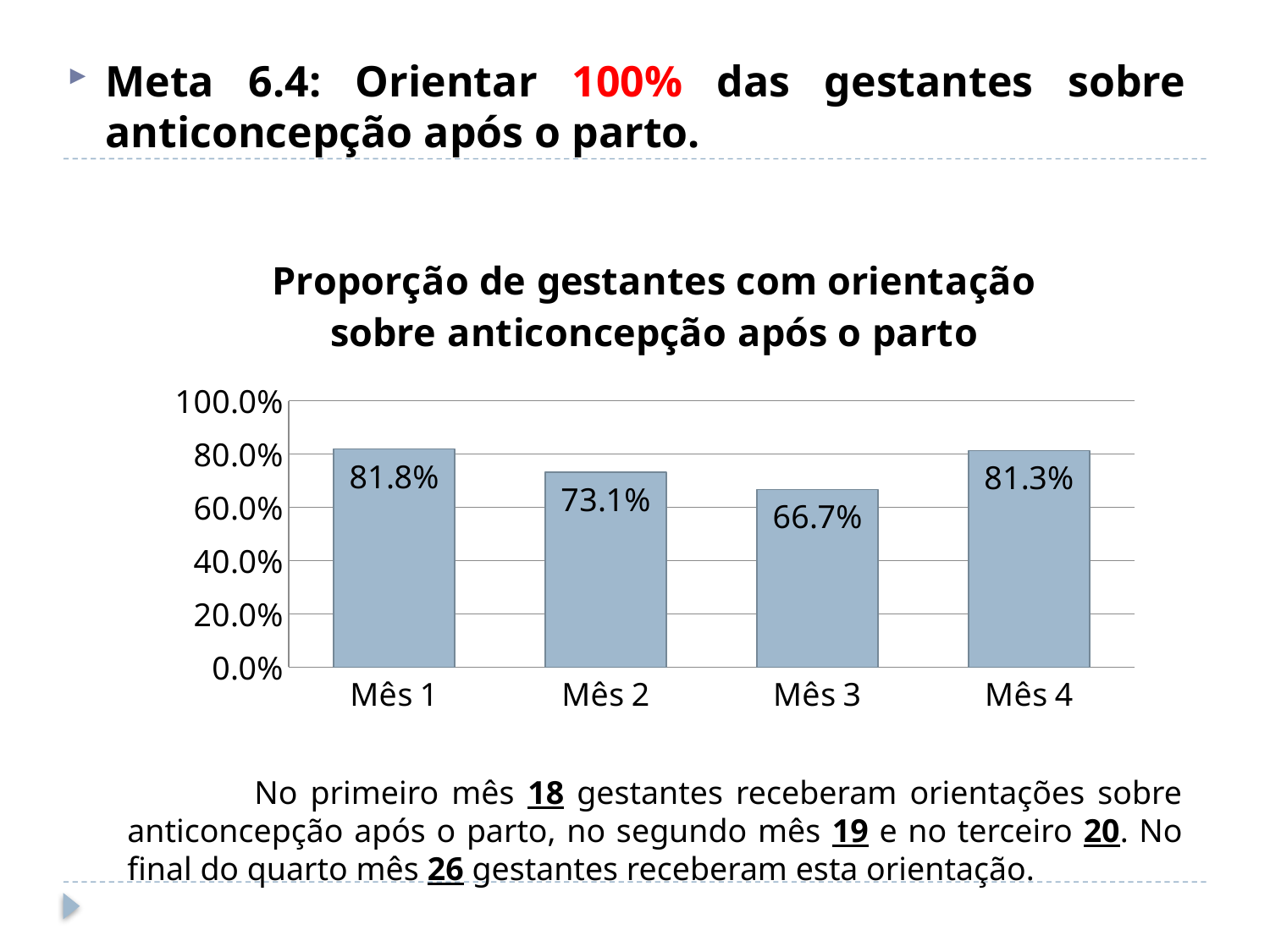
What is the value for Mês 4? 81.3% Which month has the highest value? Mês 1 What kind of chart is shown on the slide? bar chart What is the value for Mês 2? 73.1% What is the value for Mês 1? 81.8% How many months are shown on the x axis? 4 Which month has the lowest value? Mês 3 What is the difference between the values for Mês 1 and Mês 3? 15.1% Which is larger, the value for Mês 2 or the value for Mês 4? Mês 4 What is the title of the chart? Proporção de gestantes com orientação sobre anticoncepção após o parto Is the value for Mês 3 greater or less than 80.0%? less What is the value for Mês 3? 66.7%